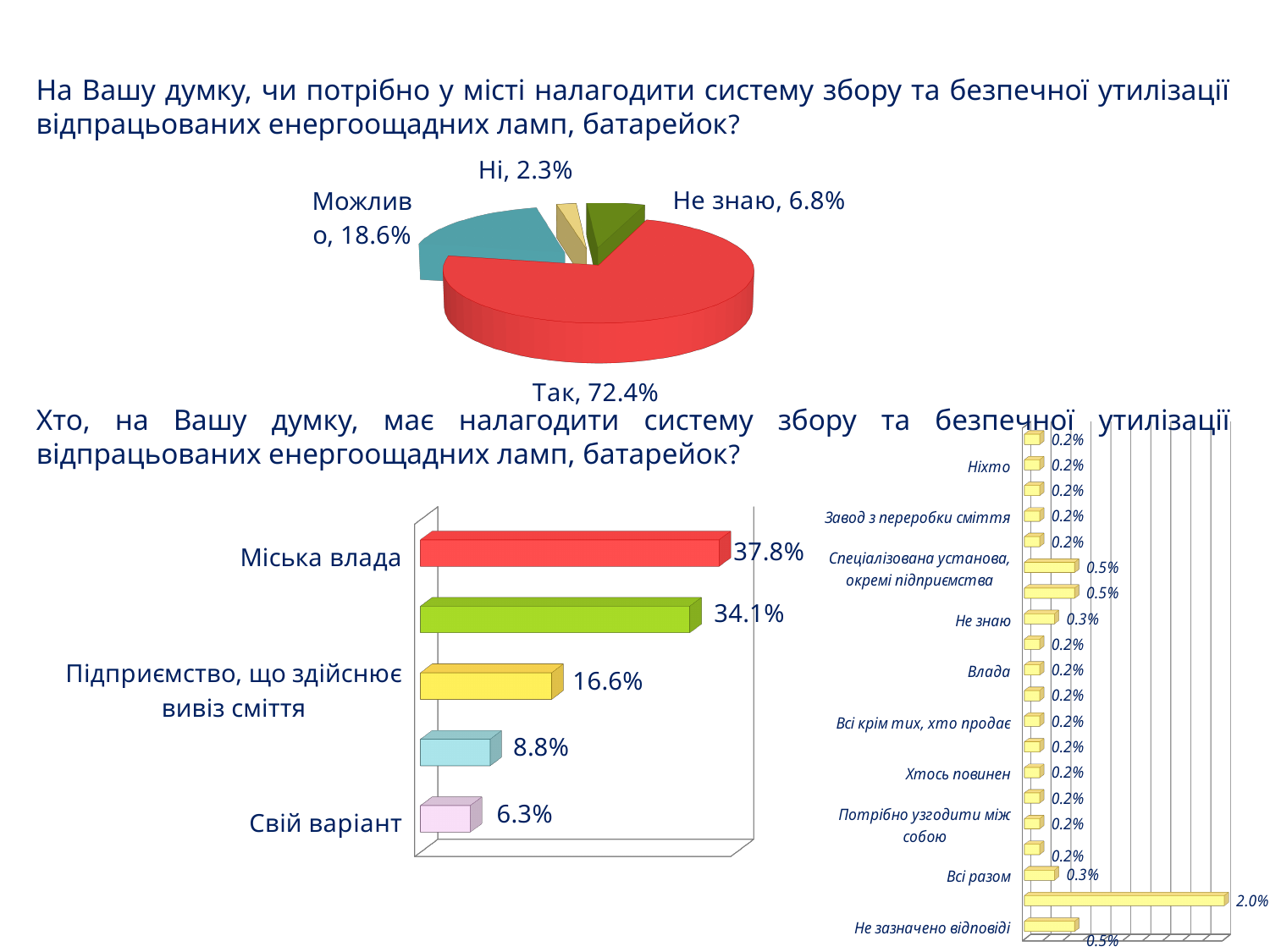
In the pie chart at the top of the slide, what percentage is shown for "Так"? 72.4% In the bar chart at the bottom left of the slide, what is the difference between the values for "Міська влада" and "Підприємство, що здійснює вивіз сміття"? 21.2% What type of chart is the chart at the top of the slide? Pie chart In the pie chart at the top of the slide, what is the difference between the shares for "Так" and "Можливо"? 53.8% In the bar chart at the bottom left of the slide, what value is shown for "Свій варіант"? 6.3% In the pie chart at the top of the slide, which answer has the largest share? Так In the pie chart at the top of the slide, which answer has the smallest share? Ні In the bar chart at the bottom left of the slide, what value is shown for "Міська влада"? 37.8% How many bars are there in the bar chart at the bottom left of the slide? 5 How many slices does the pie chart at the top of the slide have? 4 In the pie chart at the top of the slide, what percentage is shown for "Можливо"? 18.6% In the bar chart at the bottom right of the slide, what is the largest value shown? 2.0%